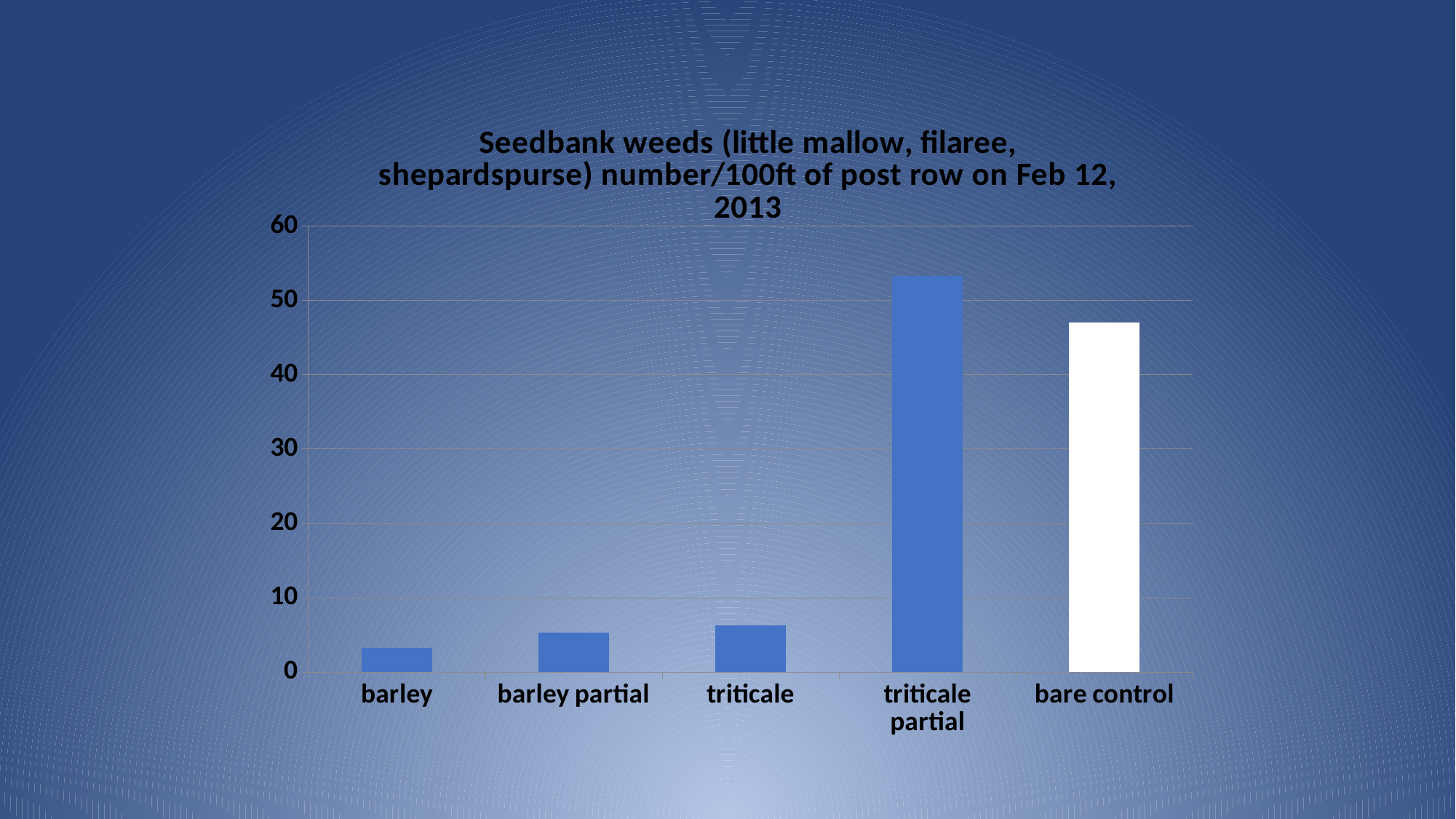
Which category's bar is coloured white rather than blue? bare control Which is larger, the value for barley or the value for triticale? triticale Is the value for bare control greater or less than 40? greater Is the value for triticale partial greater or less than 50? greater What kind of chart is shown on the slide? bar chart Is the value for barley greater or less than 10? less Which is larger, the value for triticale partial or the value for bare control? triticale partial How many categories are shown on the x axis of the chart? 5 Which category has the lowest value in the chart? barley What is the highest tick value shown on the vertical axis of the chart? 60 Which category has the highest value in the chart? triticale partial